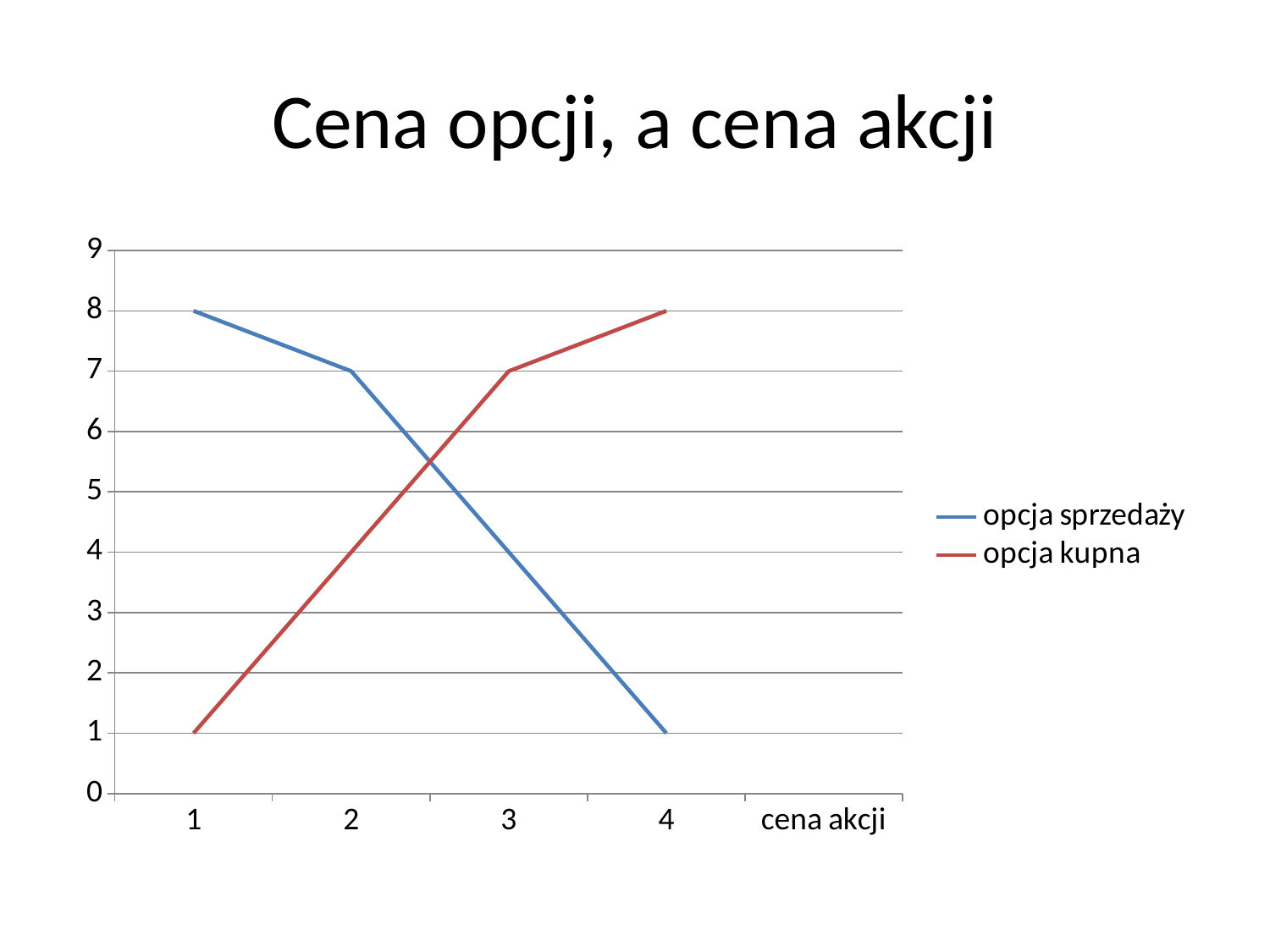
At which cena akcji is opcja kupna lowest? 1 What is the value of opcja kupna at cena akcji 4? 8 What is the title of the chart slide? Cena opcji, a cena akcji What kind of chart is shown on the slide? line chart What is the value of opcja kupna at cena akcji 1? 1 At cena akcji 4, which series has the larger value, opcja sprzedaży or opcja kupna? opcja kupna At which cena akcji is opcja sprzedaży highest? 1 What is the value of opcja sprzedaży at cena akcji 1? 8 What is the value of opcja sprzedaży at cena akcji 4? 1 Does opcja sprzedaży rise or fall as cena akcji increases? fall How many series does the legend list? 2 Does opcja kupna rise or fall as cena akcji increases? rise